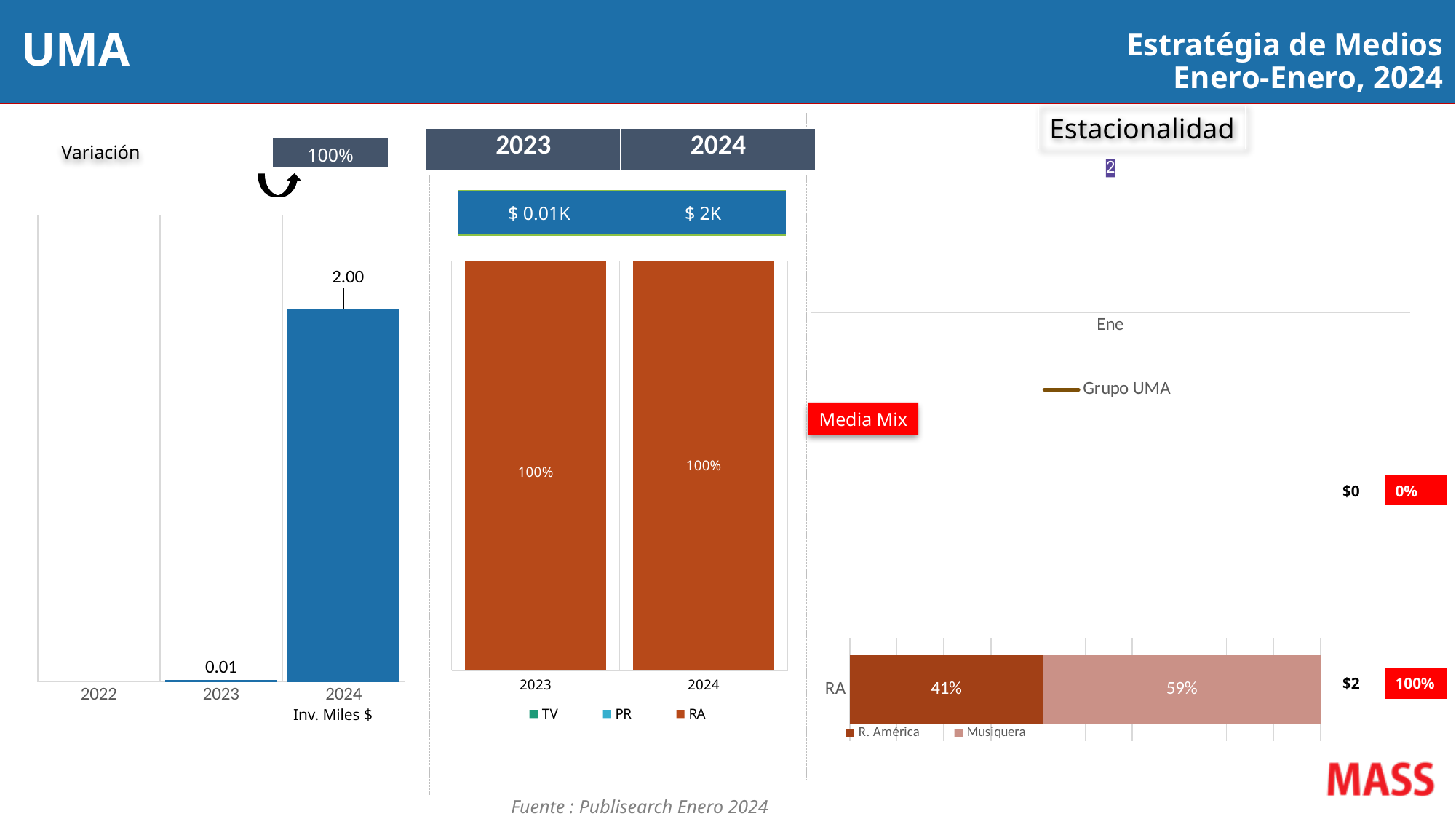
In the middle chart, what investment value is shown in the header for 2024? $ 2K In the 'Media Mix' chart, what percentage is shown for R. América? 41% In the middle stacked bar chart, what share of the 2024 bar is RA? 100% In the left-hand 'Inv. Miles $' bar chart, how many year categories are shown on the x axis? 3 In the middle stacked bar chart comparing 2023 and 2024, how many series does the legend list? 3 In the 'Media Mix' chart, which is larger, R. América or Musiquera? Musiquera In the left-hand 'Inv. Miles $' bar chart, which year has the highest value? 2024 In the left-hand 'Inv. Miles $' bar chart, what is the difference between the 2024 and 2023 values? 1.99 In the 'Media Mix' chart, what is the difference between the Musiquera and R. América percentages? 18% What percentage variation is shown above the left-hand 'Inv. Miles $' bar chart? 100% In the left-hand 'Inv. Miles $' bar chart, what is the value for 2024? 2.00 In the left-hand 'Inv. Miles $' bar chart, what is the value for 2023? 0.01